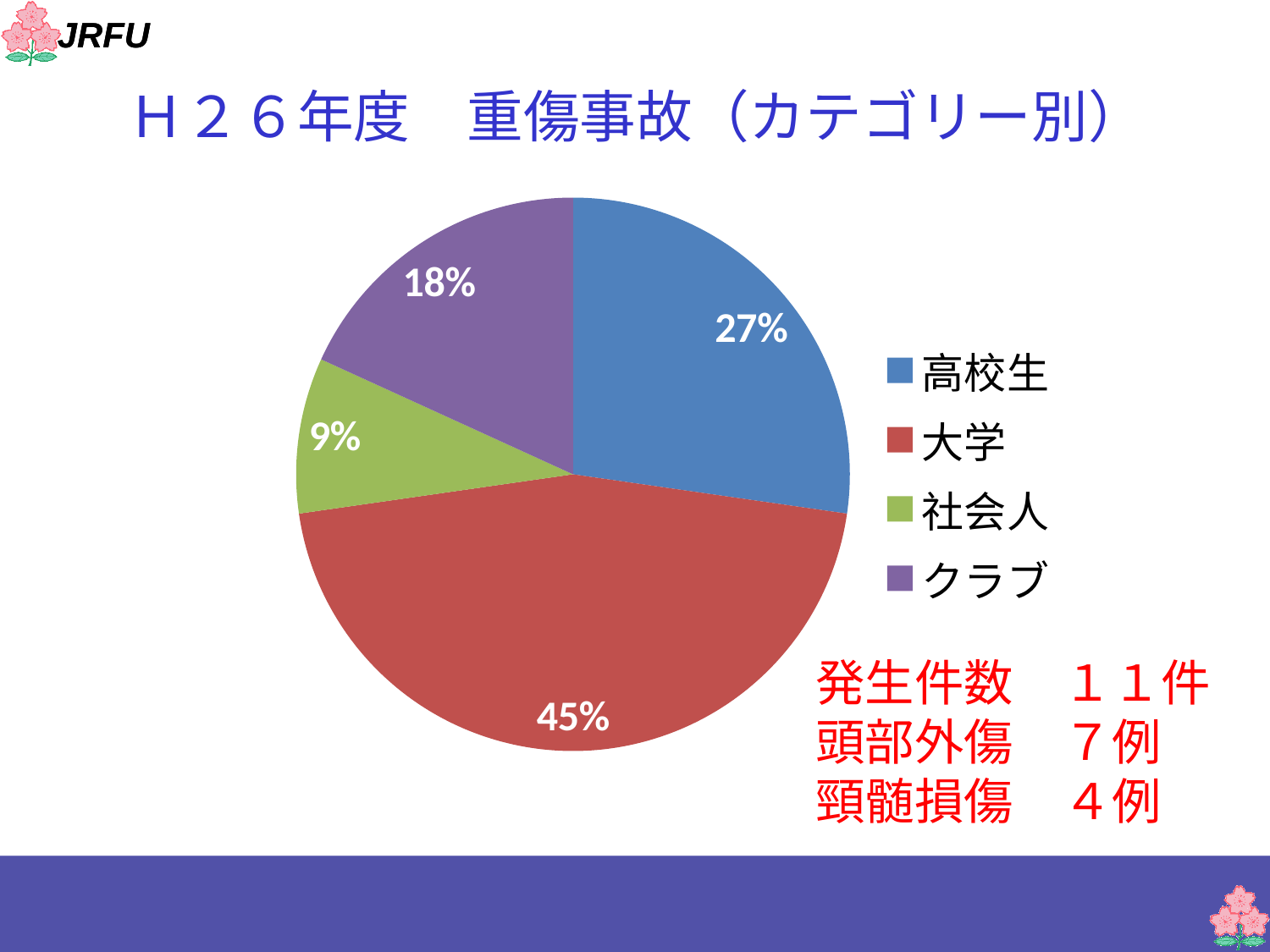
Which category has the largest slice of the pie? 大学 What is the title of the chart on the slide? Ｈ２６年度 重傷事故（カテゴリー別） What share of the pie does 社会人 have? 9% What colour is the slice for 社会人? green How many categories are shown in the pie chart? 4 Which category has the smallest slice of the pie? 社会人 What share of the pie does 大学 have? 45% Which is larger, the share for クラブ or the share for 社会人? クラブ What share of the pie does 高校生 have? 27% What is the difference in percentage points between 大学 and 高校生? 18 What type of chart is shown on the slide? pie chart